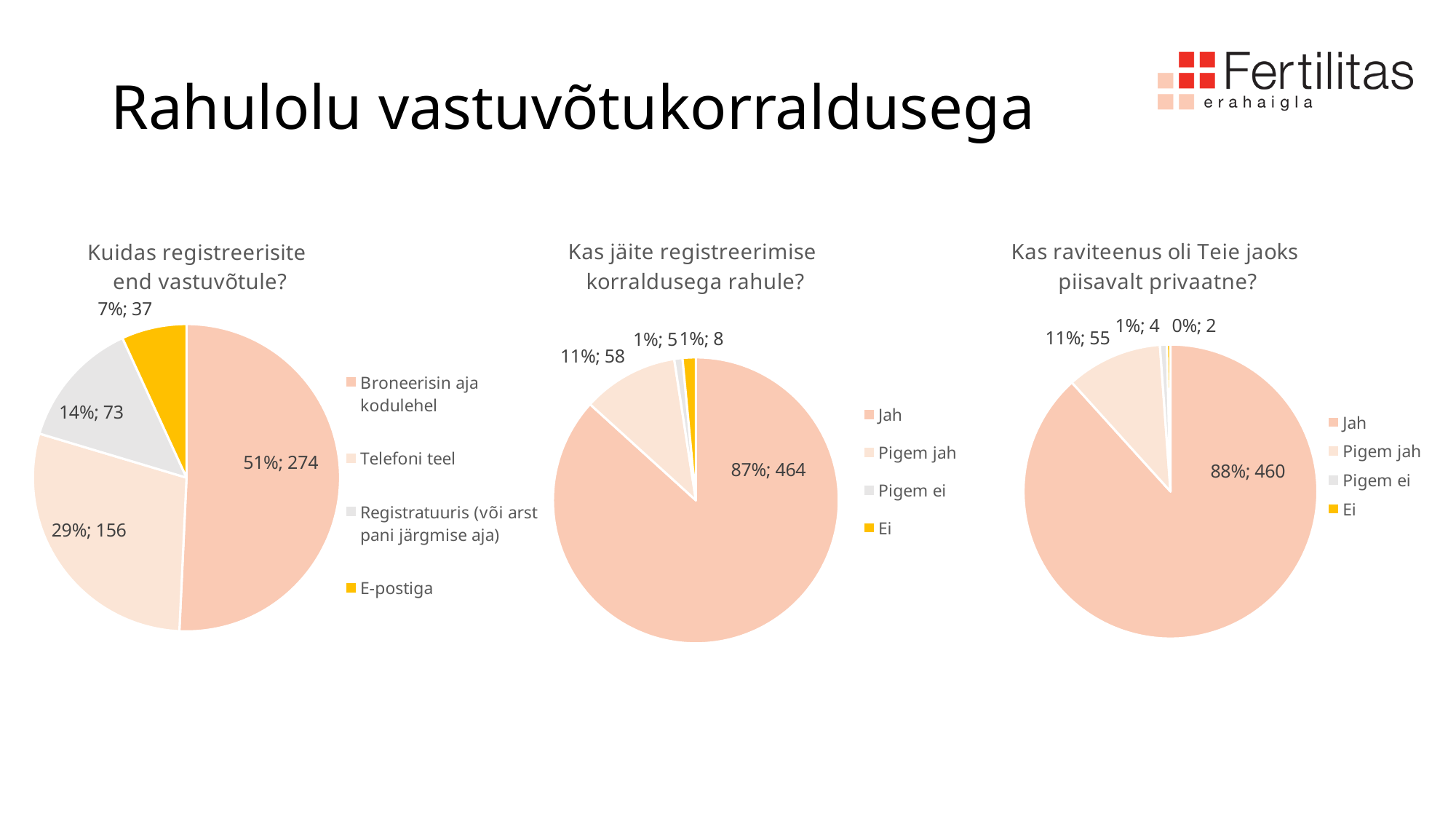
In the chart titled "Kas jäite registreerimise korraldusega rahule?", what percentage share does "Pigem jah" have? 11% In the chart titled "Kas jäite registreerimise korraldusega rahule?", which has more respondents, "Pigem ei" or "Ei"? Ei In the chart titled "Kas jäite registreerimise korraldusega rahule?", how many respondents answered "Jah"? 464 In the chart titled "Kas raviteenus oli Teie jaoks piisavalt privaatne?", how many respondents answered "Ei"? 2 In the chart titled "Kas raviteenus oli Teie jaoks piisavalt privaatne?", what is the difference in respondent counts between "Jah" and "Pigem jah"? 405 In the chart titled "Kuidas registreerisite end vastuvõtule?", how many categories does the legend list? 4 In the chart titled "Kas raviteenus oli Teie jaoks piisavalt privaatne?", which category has the largest slice? Jah In the chart titled "Kuidas registreerisite end vastuvõtule?", how many respondents chose "Telefoni teel"? 156 In the chart titled "Kuidas registreerisite end vastuvõtule?", what is the difference in respondent counts between "Telefoni teel" and "Registratuuris (või arst pani järgmise aja)"? 83 In the chart titled "Kuidas registreerisite end vastuvõtule?", which category has the smallest slice? E-postiga In the chart titled "Kuidas registreerisite end vastuvõtule?", what percentage share does "Broneerisin aja kodulehel" have? 51% What type of chart is used for the three charts on this slide? Pie chart